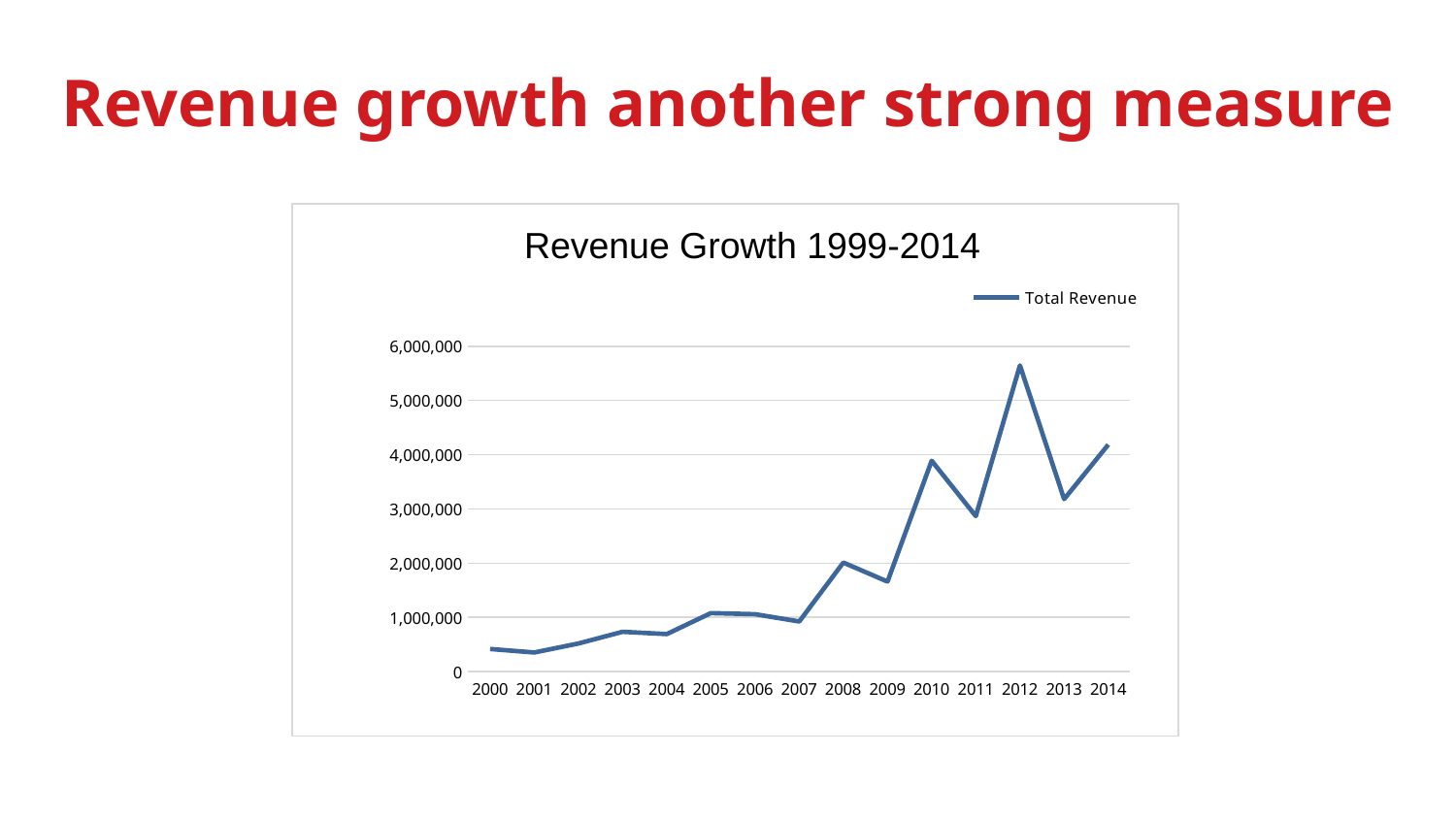
Is the value for 2012 greater or less than 5,000,000? greater In which year is Total Revenue highest? 2012 What is the name of the series shown in the legend? Total Revenue Which year has the larger Total Revenue, 2012 or 2014? 2012 How many years are plotted along the x axis? 15 How many series does the legend list? 1 What kind of chart is shown on the slide? Line chart Is the value for 2008 greater or less than 1,000,000? greater Which year has the larger Total Revenue, 2010 or 2011? 2010 What is the title of the chart? Revenue Growth 1999-2014 Is the value for 2003 greater or less than 1,000,000? less Overall, does Total Revenue rise or fall from 2000 to 2014? rise